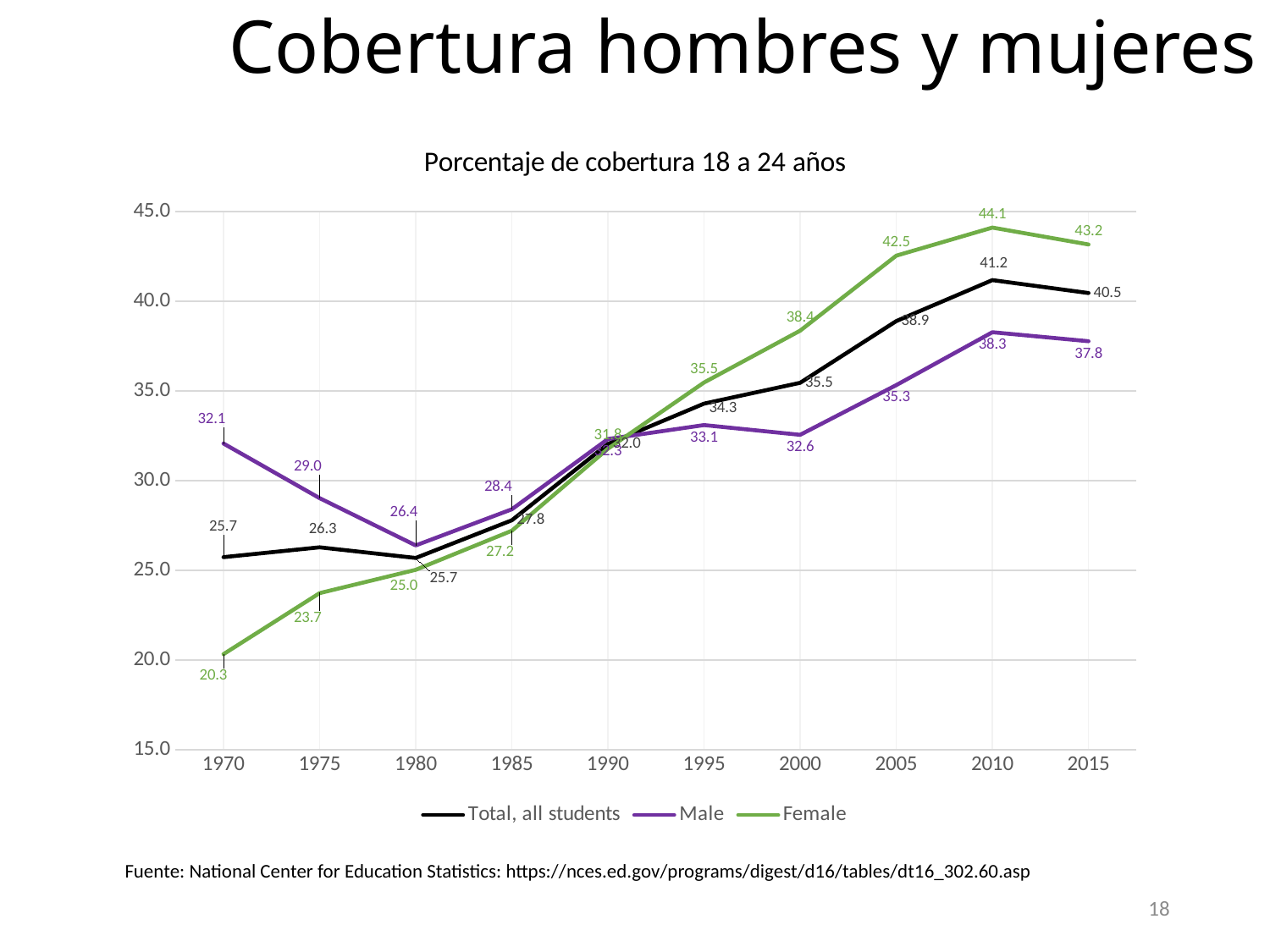
What is the value for Total, all students in 2015? 40.5 How many years are shown on the x axis? 10 In 1970, which is larger, the Male value or the Female value? Male What is the Female value for 2010? 44.1 In which year does the Female series reach its highest value? 2010 What is the difference between the Female and Male values in 2015? 5.4 How many series does the legend list? 3 In which year is the Male series at its lowest value? 1980 What kind of chart is shown on the slide? line chart Is the value for Total, all students in 2005 greater or less than 40.0? less What is the Male value for 1970? 32.1 Does the Female series generally rise or fall from 1970 to 2010? rise